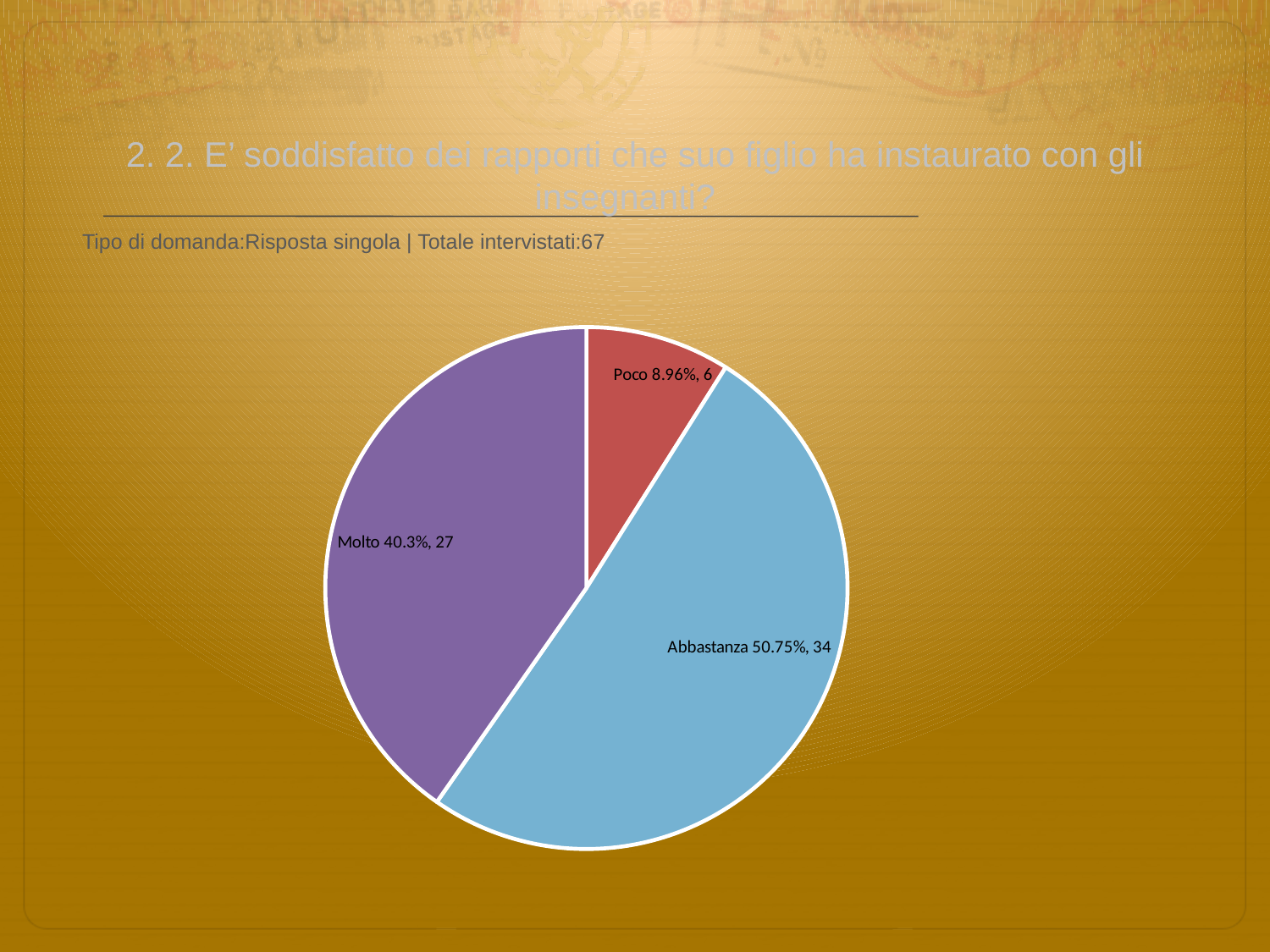
How many respondents answered Abbastanza? 34 What kind of chart is shown on the slide? pie chart Which slice is larger, Molto or Poco? Molto Which response has the smallest slice of the pie? Poco What percentage share does the Poco slice have? 8.96% How many respondents answered Poco? 6 What percentage share does the Abbastanza slice have? 50.75% Which response has the largest slice of the pie? Abbastanza What percentage share does the Molto slice have? 40.3% How many slices does the pie chart have? 3 What is the difference in respondent count between Abbastanza and Molto? 7 How many respondents answered Molto? 27